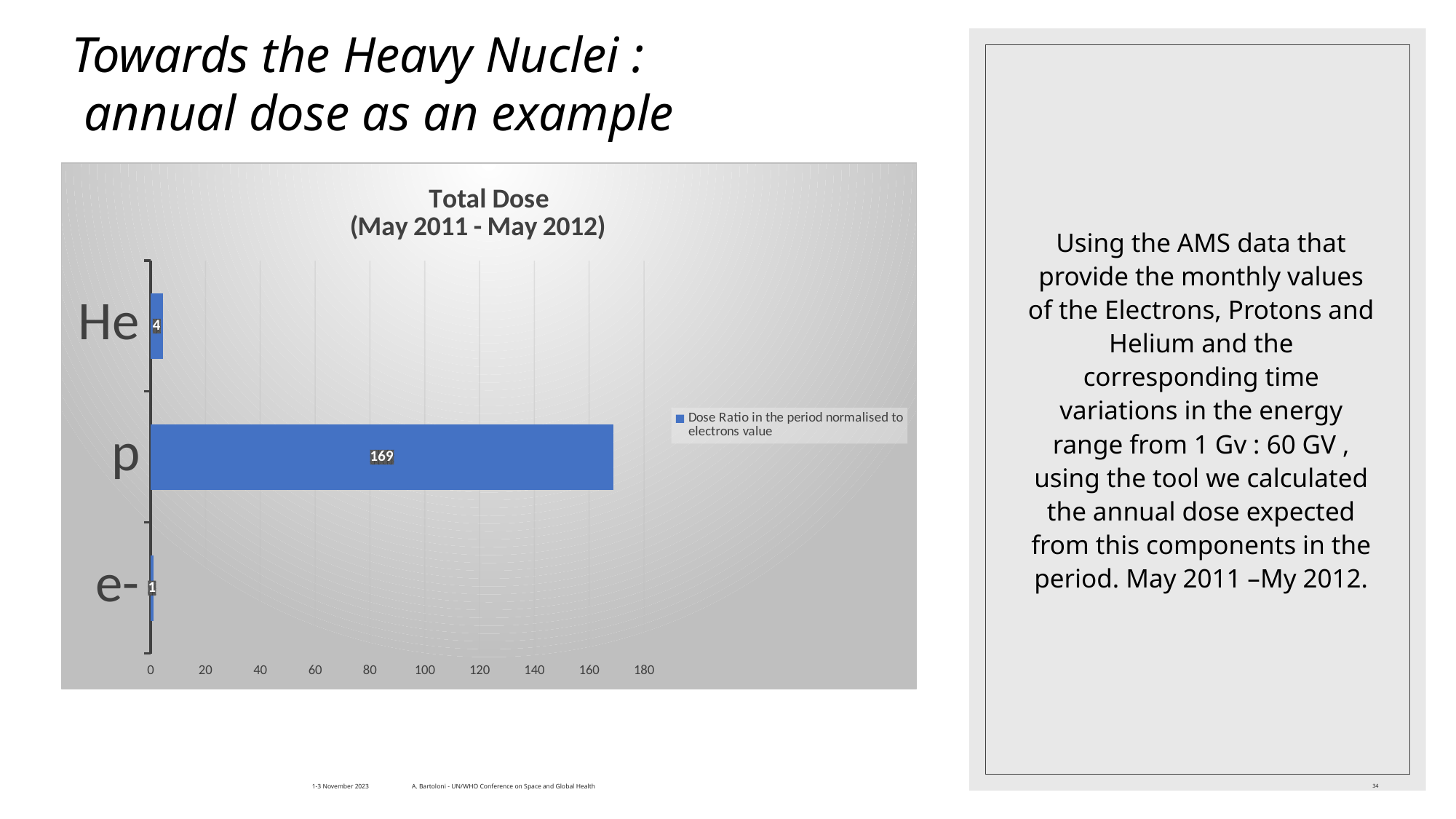
Which category has the lowest value in the Total Dose chart? e- Is the value for p greater or less than 160? greater What is the value for e- in the Total Dose chart? 1 How many categories are shown in the Total Dose chart? 3 What is the difference between the values for p and He? 165 Which category has the highest value in the Total Dose chart? p Which is larger, the value for He or the value for e-? He What is the value for He in the Total Dose chart? 4 What is the legend entry of the series in the Total Dose chart? Dose Ratio in the period normalised to electrons value What kind of chart is shown on the slide? bar chart What is the difference between the values for He and e-? 3 What is the value for p in the Total Dose chart? 169